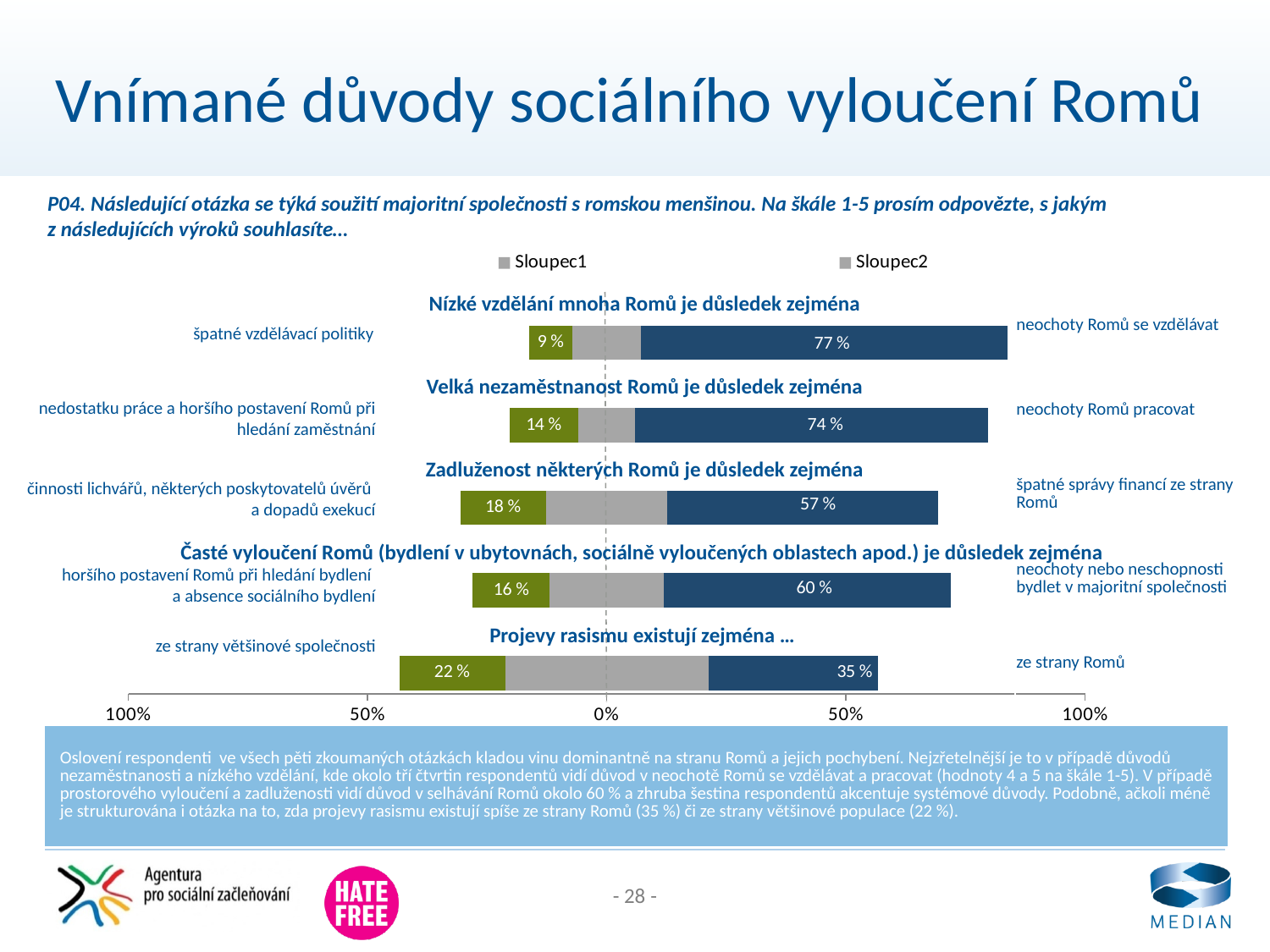
What type of chart is shown on the slide? Bar chart What is the difference between the share blaming 'neochoty Romů pracovat' (74 %) and the share blaming 'nedostatku práce a horšího postavení Romů při hledání zaměstnání' (14 %)? 60 percentage points How many series does the legend list? 2 Which statement has the lowest green (left-hand) value? Nízké vzdělání mnoha Romů je důsledek zejména How many statements (question items) are shown in the chart? 5 For the statement about manifestations of racism, which is larger: the share saying 'ze strany Romů' or the share saying 'ze strany většinové společnosti'? ze strany Romů What percentage of respondents attribute the indebtedness of some Roma to 'špatné správy financí ze strany Romů'? 57 % What percentage of respondents attribute the low education of many Roma to 'neochoty Romů se vzdělávat'? 77 % Which statement has the highest blue (right-hand) value? Nízké vzdělání mnoha Romů je důsledek zejména What percentage of respondents say manifestations of racism exist mainly 'ze strany většinové společnosti'? 22 % What percentage of respondents say high Roma unemployment is mainly a result of 'neochoty Romů pracovat'? 74 % What percentage of respondents attribute the low education of many Roma to 'špatné vzdělávací politiky'? 9 %